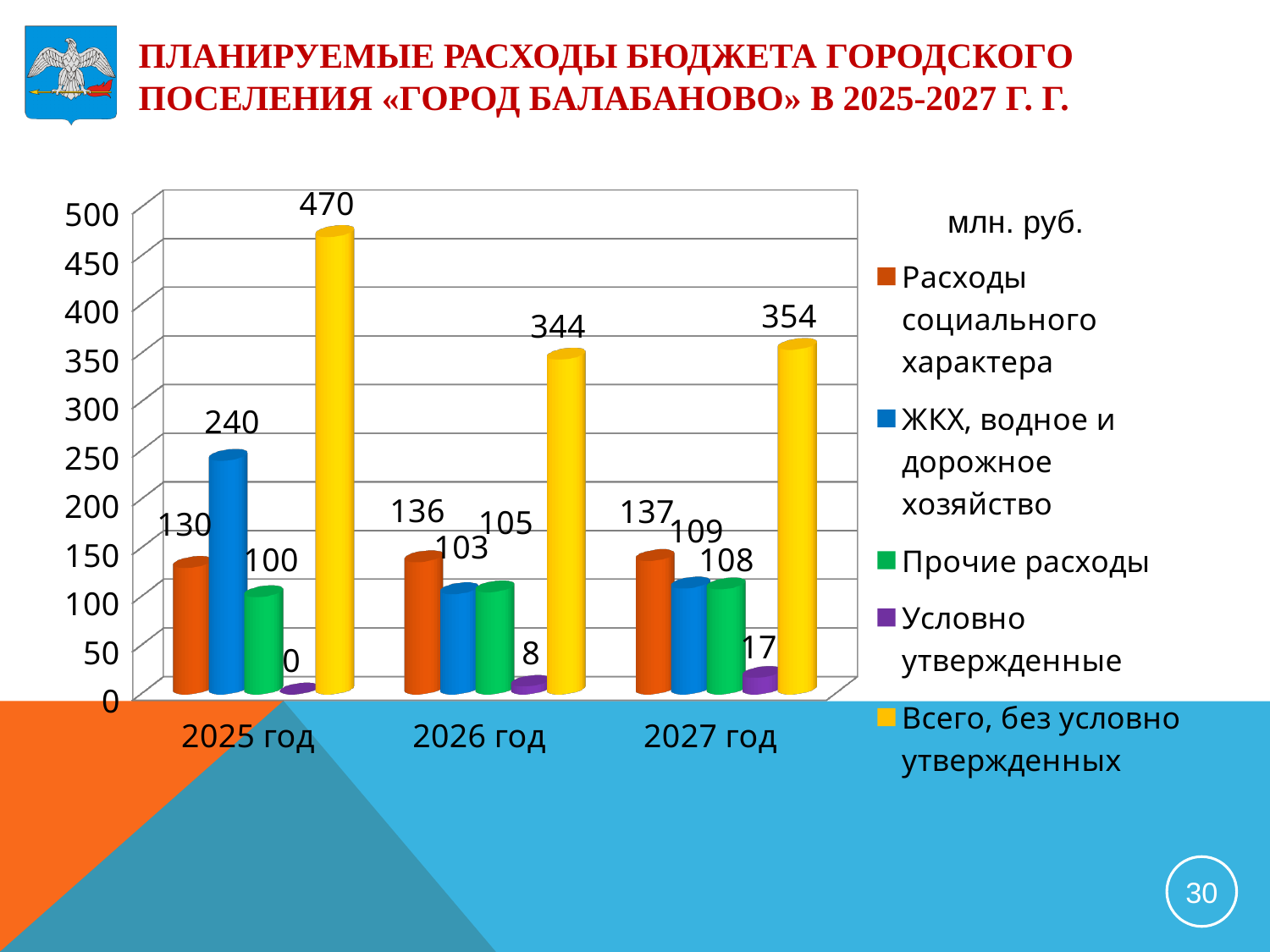
Which is larger: «ЖКХ, водное и дорожное хозяйство» in 2025 год or «Прочие расходы» in 2025 год? ЖКХ, водное и дорожное хозяйство What unit is indicated above the legend? млн. руб. What kind of chart is shown on the slide? Bar chart What is the difference between «Всего, без условно утвержденных» in 2025 год and 2026 год? 126 What is the value for «Всего, без условно утвержденных» in 2025 год? 470 What is the value for «Условно утвержденные» in 2027 год? 17 In which year is «Условно утвержденные» the lowest? 2025 год In which year is «Всего, без условно утвержденных» the highest? 2025 год What is the value for «Расходы социального характера» in 2027 год? 137 What is the value for «ЖКХ, водное и дорожное хозяйство» in 2026 год? 103 How many series does the legend list? 5 How many year categories are shown on the x axis? 3